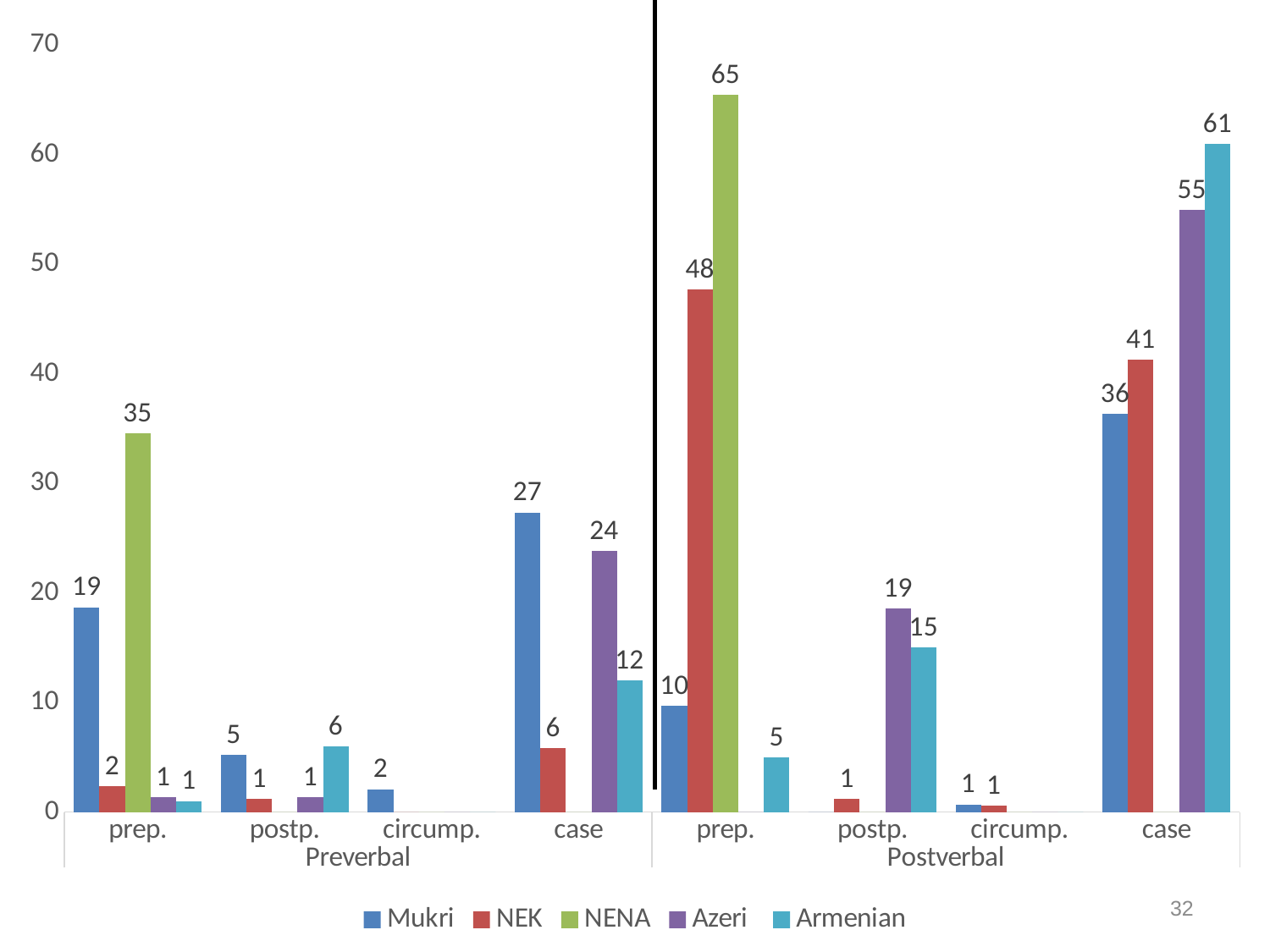
Is the value for Azeri in the Postverbal case category greater or less than 50? greater Which series is shown in green in the legend? NENA What is the difference between the Mukri value for Preverbal case and the Mukri value for Postverbal case? 9 What is the difference between the NENA value and the NEK value in the Postverbal prep. category? 17 What is the value for Azeri in the Postverbal postp. category? 19 What is the value for Armenian in the Postverbal case category? 61 How many series does the legend list? 5 What is the value for NENA in the Preverbal prep. category? 35 What kind of chart is shown on the slide? bar chart Which series has the highest value in the Postverbal prep. category? NENA Which is larger in the Postverbal case category, the Mukri value or the NEK value? NEK